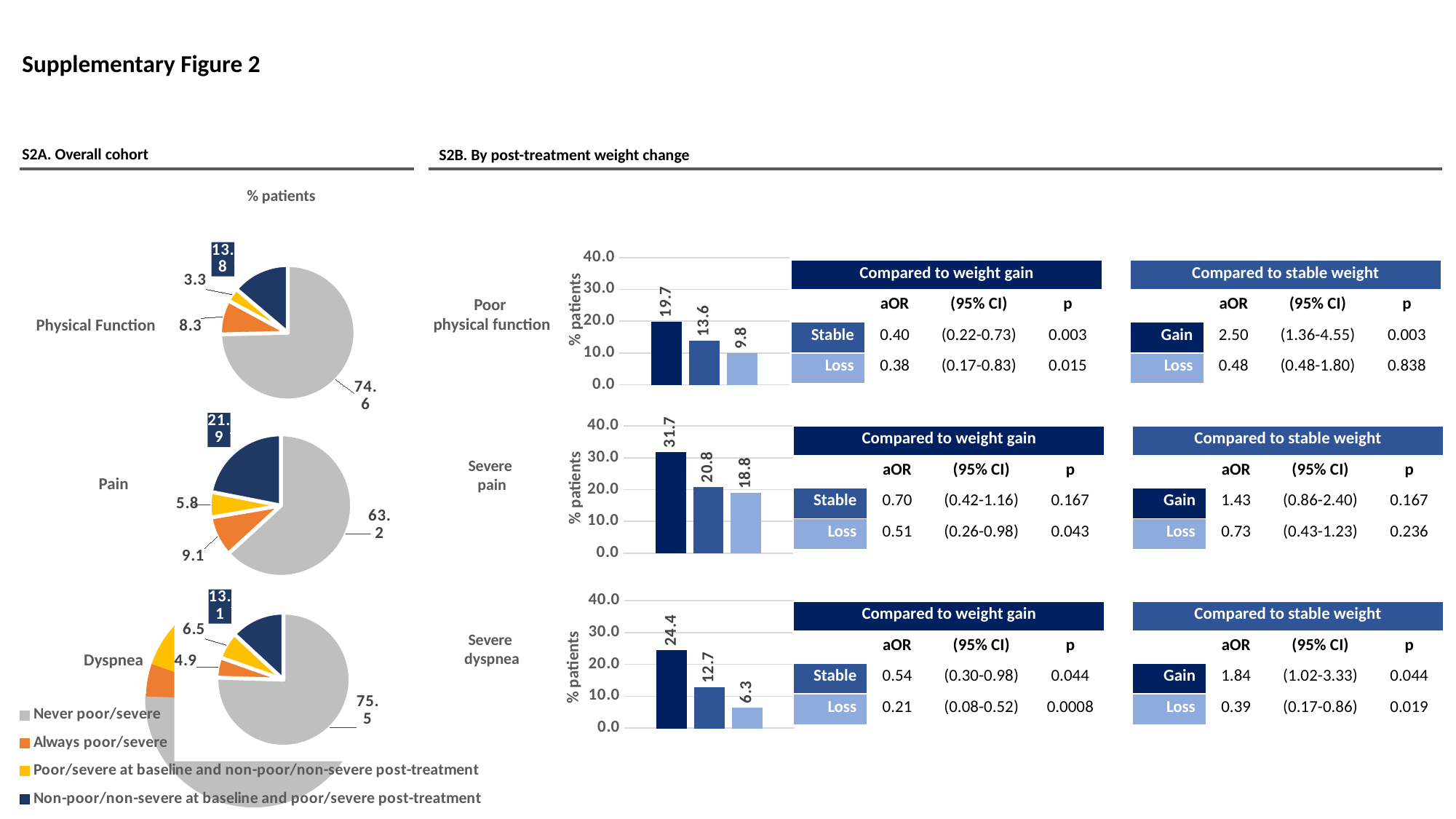
In the Pain pie chart, what value is shown for the dark navy slice (non-poor/non-severe at baseline and poor/severe post-treatment)? 21.9 Which of the three pie charts has the smallest grey (never poor/severe) slice? Pain In the Poor physical function bar chart, what is the difference between the dark navy bar (19.7) and the light blue bar (9.8)? 9.9 In the Severe dyspnea bar chart, is the value of the medium blue bar greater or less than 10.0? greater In the Physical Function pie chart, what percentage of patients is shown for the largest (grey) slice? 74.6 In the Physical Function pie chart, what is the difference between the orange slice (8.3) and the yellow slice (3.3)? 5.0 In the Dyspnea pie chart, what value is shown for the orange slice (always poor/severe)? 4.9 In the Severe dyspnea bar chart, what is the value of the light blue bar? 6.3 In the Severe pain bar chart, do the bar values rise or fall from left to right? Fall How many slices does each pie chart in S2A have? 4 What type of chart is used in section S2B to show % patients by post-treatment weight change? Bar chart In the Severe pain bar chart, what is the value of the tallest (dark navy) bar? 31.7